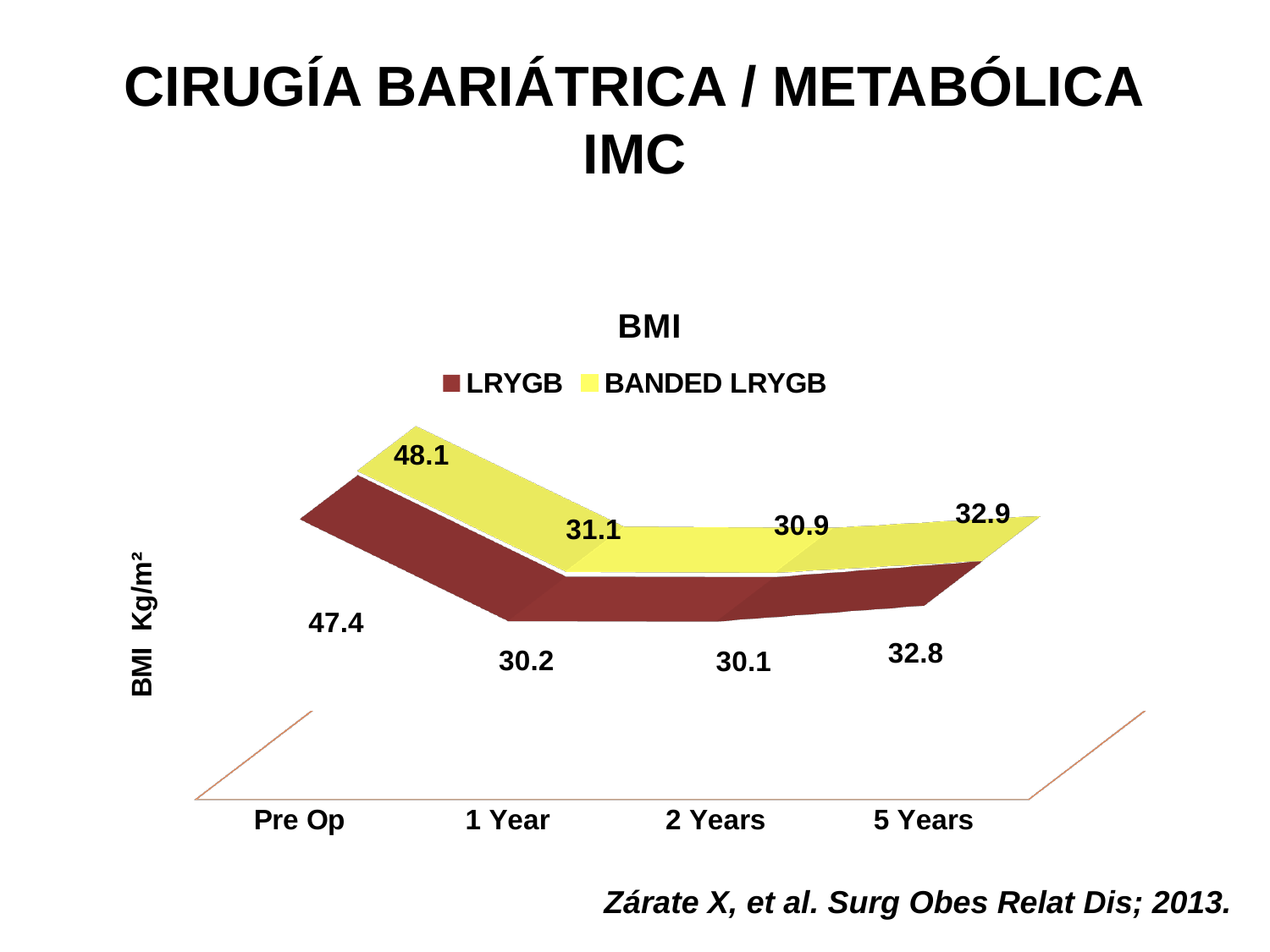
What kind of chart is shown on the slide? Line chart What is the BMI value for LRYGB at Pre Op? 47.4 At which time point is the LRYGB BMI value lowest? 2 Years What is the BMI value for BANDED LRYGB at 1 Year? 31.1 What is the difference between the BANDED LRYGB and LRYGB BMI values at Pre Op? 0.7 Which series has the larger BMI value at 1 Year, LRYGB or BANDED LRYGB? BANDED LRYGB At which time point is the BANDED LRYGB BMI value highest? Pre Op What is the BMI value for LRYGB at 5 Years? 32.8 How many series does the chart legend list? 2 How many time points are shown on the x axis of the chart? 4 What is the difference between the Pre Op and 1 Year BMI values for LRYGB? 17.2 What is the BMI value for BANDED LRYGB at 2 Years? 30.9